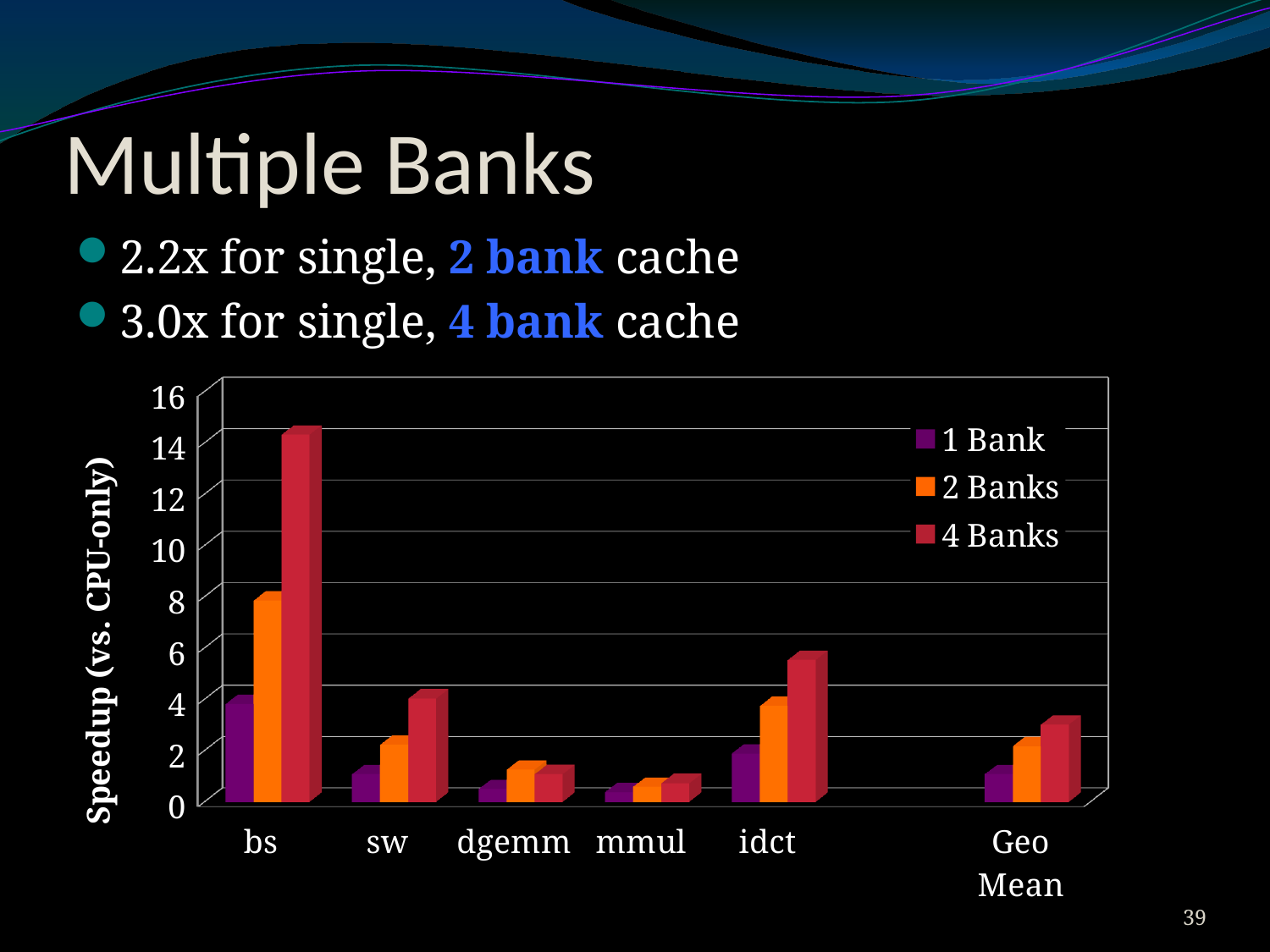
How many series does the legend list? 3 Which category has the lowest 4 Banks speedup? mmul What is the label on the vertical axis of the chart? Speedup (vs. CPU-only) How many categories are shown on the x axis? 6 Which is larger, the 4 Banks value for bs or the 4 Banks value for idct? bs Which category has the highest 4 Banks speedup? bs What kind of chart is shown on the slide? bar chart Is the 4 Banks value for bs greater or less than 12? greater Which category has the highest 2 Banks speedup? bs Is the 2 Banks value for bs greater or less than 6? greater Is the 4 Banks value for mmul greater or less than 2? less For sw, which is larger, the 2 Banks value or the 4 Banks value? 4 Banks